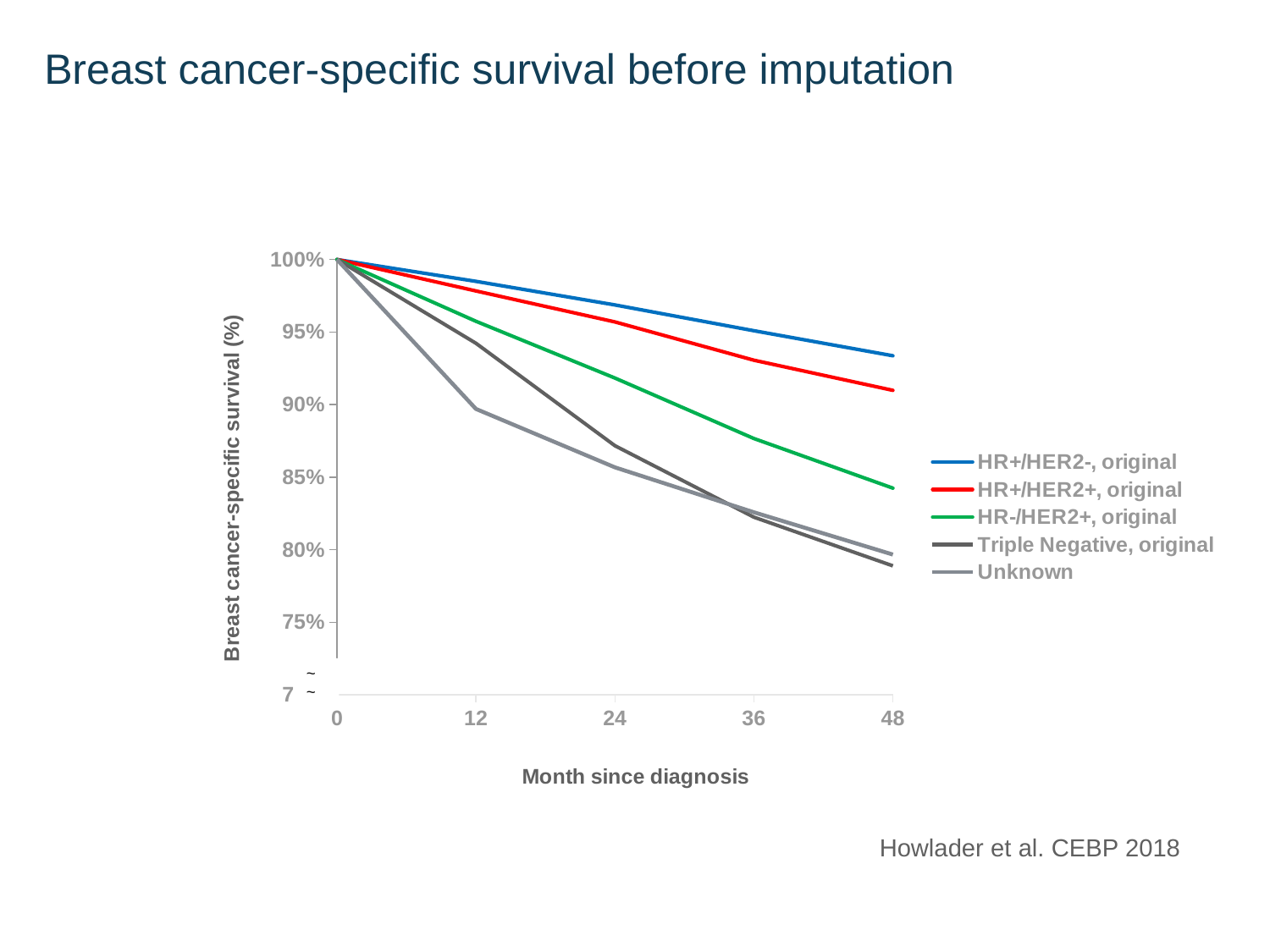
Is the survival for Triple Negative, original at 24 months greater or less than 90%? less What is the breast cancer-specific survival for HR+/HER2-, original at month 0? 100% Which series has the lowest survival at 12 months since diagnosis? Unknown Do the survival curves rise or fall as months since diagnosis increase? Fall What type of chart is shown on the slide? Line chart How many series does the legend list? 5 At 24 months, which series has higher survival: HR+/HER2+, original or HR-/HER2+, original? HR+/HER2+, original Is the survival for Unknown at 36 months greater or less than 85%? less At 12 months, which series has higher survival: Triple Negative, original or Unknown? Triple Negative, original Is the survival for HR+/HER2-, original at 48 months greater or less than 90%? greater Which series has the highest survival at 48 months since diagnosis? HR+/HER2-, original What is the label of the x axis? Month since diagnosis